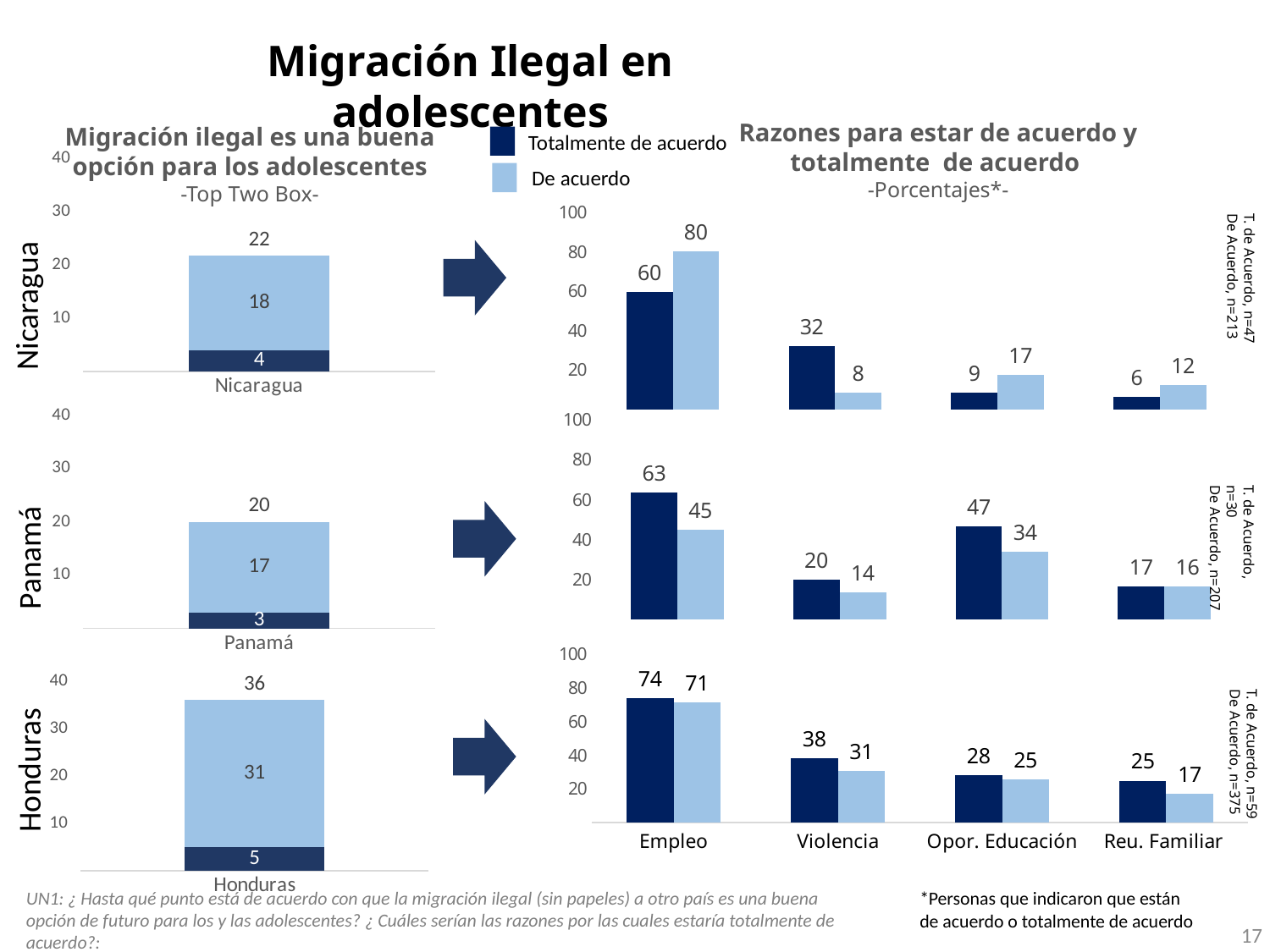
In the right-hand chart for Honduras, which reason has the highest 'Totalmente de acuerdo' value? Empleo In the left-hand stacked bar chart for Nicaragua, what is the total value shown above the bar? 22 Among the three left-hand stacked bar charts (Nicaragua, Panamá, Honduras), which country has the highest total? Honduras How many series does the legend list? 2 In the right-hand chart for Nicaragua (Razones para estar de acuerdo), what is the 'De acuerdo' value for Empleo? 80 In the right-hand chart for Honduras, what is the difference between the 'Totalmente de acuerdo' and 'De acuerdo' values for Reu. Familiar? 8 In the right-hand chart for Panamá, what is the 'Totalmente de acuerdo' value for Opor. Educación? 47 In the left-hand stacked bar chart for Panamá, what is the value of the 'Totalmente de acuerdo' segment? 3 In the right-hand chart for Nicaragua, what is the 'Totalmente de acuerdo' value for Violencia? 32 In the left-hand stacked bar chart for Honduras, what is the value of the 'De acuerdo' segment? 31 How many reason categories are shown on the x axis of the right-hand charts? 4 In the right-hand chart for Panamá, which is larger for Empleo: 'Totalmente de acuerdo' or 'De acuerdo'? Totalmente de acuerdo